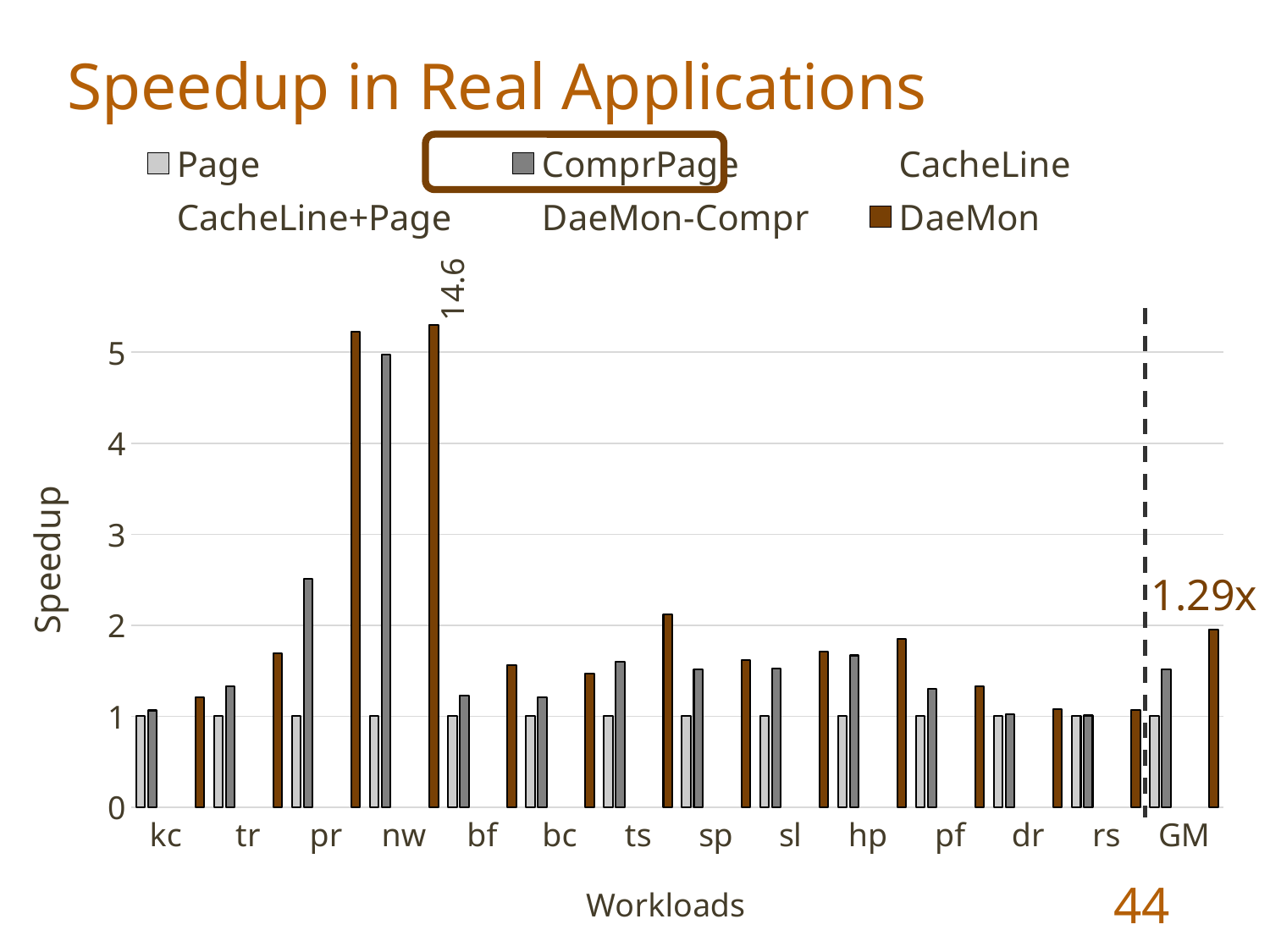
Which workload has the highest DaeMon speedup? nw Is the DaeMon speedup for ts greater or less than 2? greater What is the title of the chart's x axis? Workloads Is the ComprPage speedup for pr greater or less than 2? greater For the tr workload, which is larger: the ComprPage speedup or the DaeMon speedup? DaeMon What is the title of the chart's y axis? Speedup How many series does the chart's legend list? 6 What kind of chart is shown on the slide? bar chart What is the DaeMon speedup for the nw workload? 14.6 How many workloads are listed along the x axis of the chart? 14 For the pr workload, which is larger: the ComprPage speedup or the DaeMon speedup? DaeMon Is the DaeMon speedup for hp greater or less than 2? less